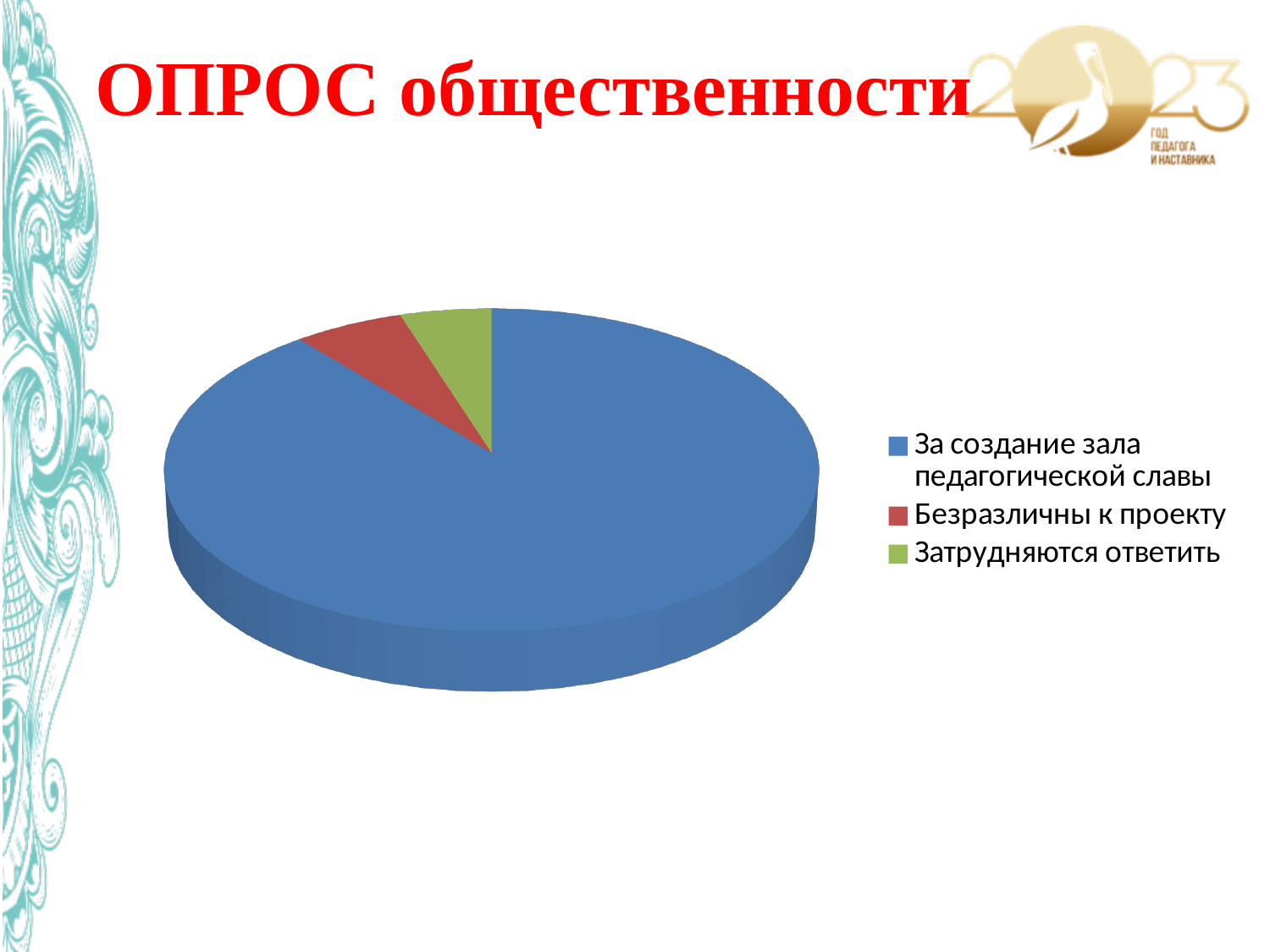
What colour is the slice for "Затрудняются ответить"? green Which slice is larger: "За создание зала педагогической славы" or "Затрудняются ответить"? За создание зала педагогической славы Which category has the largest slice in the pie chart? За создание зала педагогической славы How many slices does the pie chart have? 3 How many entries does the legend of the pie chart list? 3 Which slice is larger: "За создание зала педагогической славы" or "Безразличны к проекту"? За создание зала педагогической славы What is the title shown at the top of the slide above the pie chart? ОПРОС общественности What kind of chart is shown on the slide? pie chart Does the slice for "За создание зала педагогической славы" take up more or less than half of the pie? more